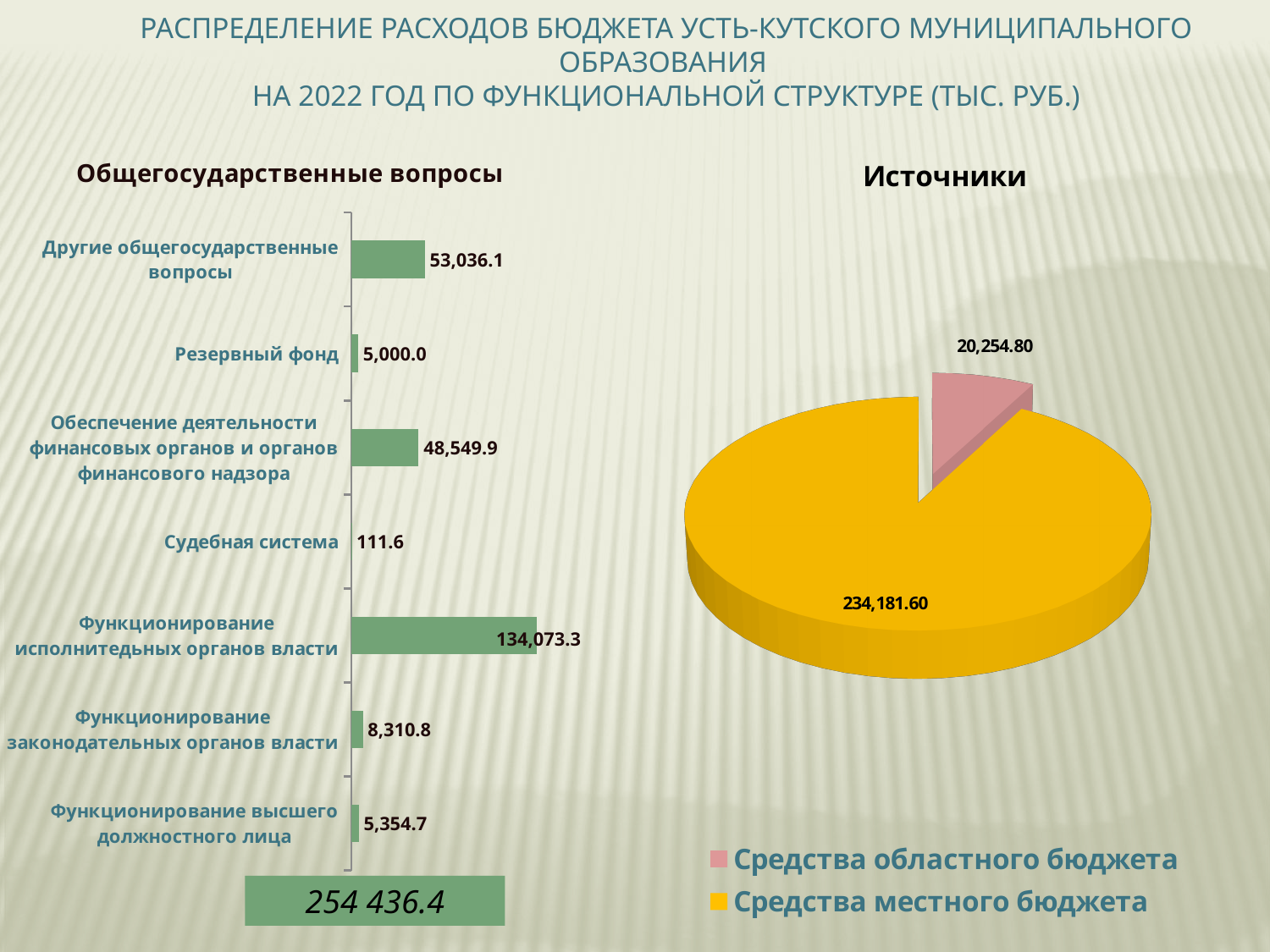
In the bar chart "Общегосударственные вопросы", which category has the highest value? Функционирование исполнительных органов власти In the pie chart "Источники", what is the value for "Средства областного бюджета"? 20,254.80 In the bar chart "Общегосударственные вопросы", which category has the lowest value? Судебная система In the pie chart "Источники", which colour represents "Средства местного бюджета"? Yellow In the bar chart "Общегосударственные вопросы", what is the difference between "Другие общегосударственные вопросы" and "Обеспечение деятельности финансовых органов и органов финансового надзора"? 4,486.2 In the bar chart "Общегосударственные вопросы", what is the value for "Резервный фонд"? 5,000.0 In the pie chart "Источники", what is the value for "Средства местного бюджета"? 234,181.60 In the bar chart "Общегосударственные вопросы", which is larger: "Функционирование законодательных органов власти" or "Функционирование высшего должностного лица"? Функционирование законодательных органов власти How many entries does the legend of the pie chart "Источники" list? 2 In the bar chart "Общегосударственные вопросы", what is the value for "Функционирование исполнительных органов власти"? 134,073.3 How many categories does the bar chart "Общегосударственные вопросы" show? 7 What kind of chart is the chart titled "Общегосударственные вопросы"? Bar chart